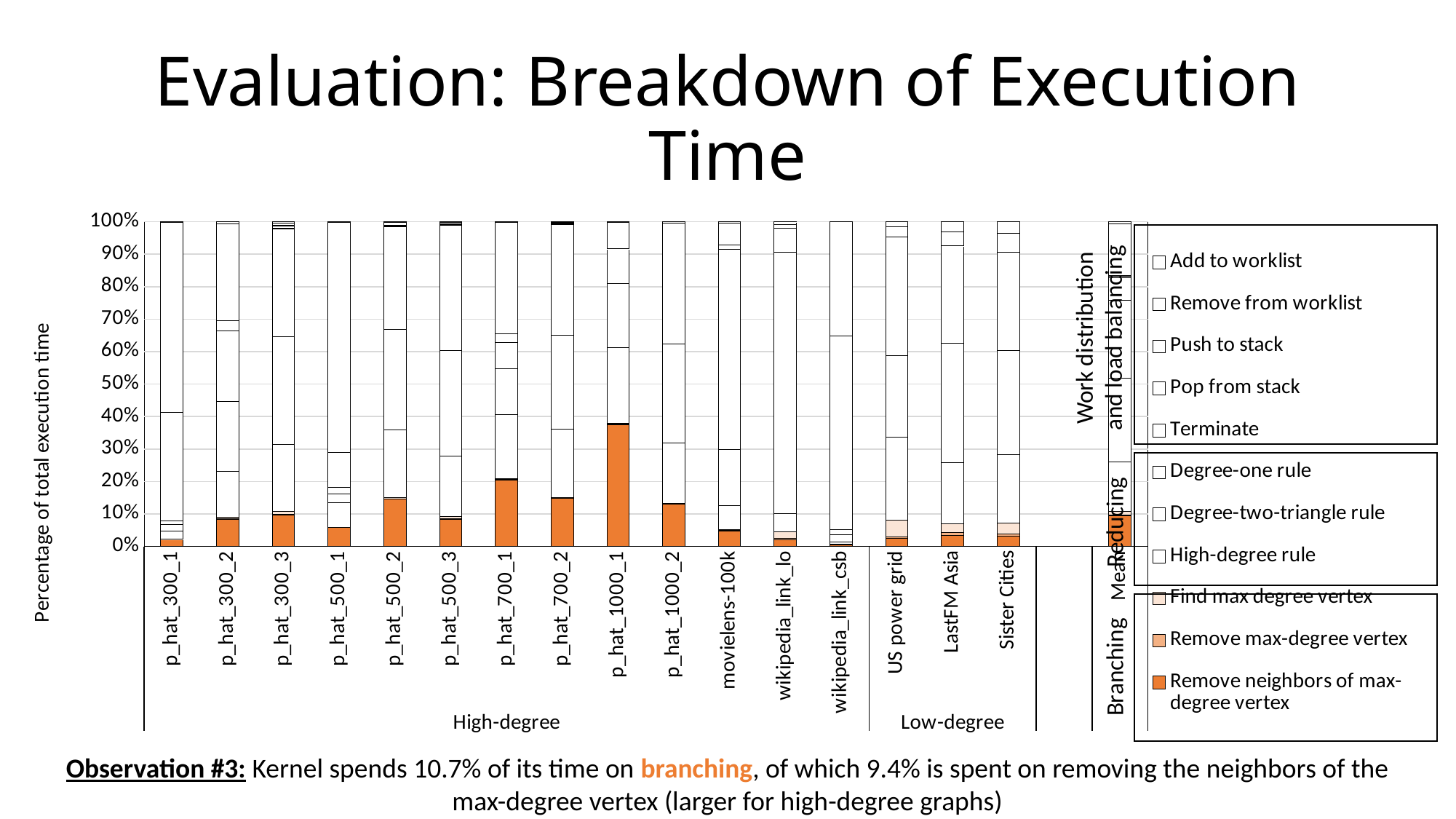
Is the 'Remove neighbors of max-degree vertex' value for p_hat_700_1 greater or less than 15%? greater Which category has the largest 'Remove neighbors of max-degree vertex' segment? p_hat_1000_1 How many categories are in the High-degree group on the x axis? 13 What is the label of the y axis? Percentage of total execution time What kind of chart is shown on the slide? stacked bar chart How many series does the legend list? 11 Is the 'Remove neighbors of max-degree vertex' value for p_hat_500_1 greater or less than 10%? less What is the total of each stacked bar in the chart? 100% Into which three groups is the legend divided? Work distribution and load balancing, Reducing, Branching How many categories are in the Low-degree group on the x axis? 3 Is the 'Remove neighbors of max-degree vertex' value for p_hat_1000_1 greater or less than 30%? greater Which has the larger 'Remove neighbors of max-degree vertex' segment, p_hat_1000_1 or p_hat_300_1? p_hat_1000_1